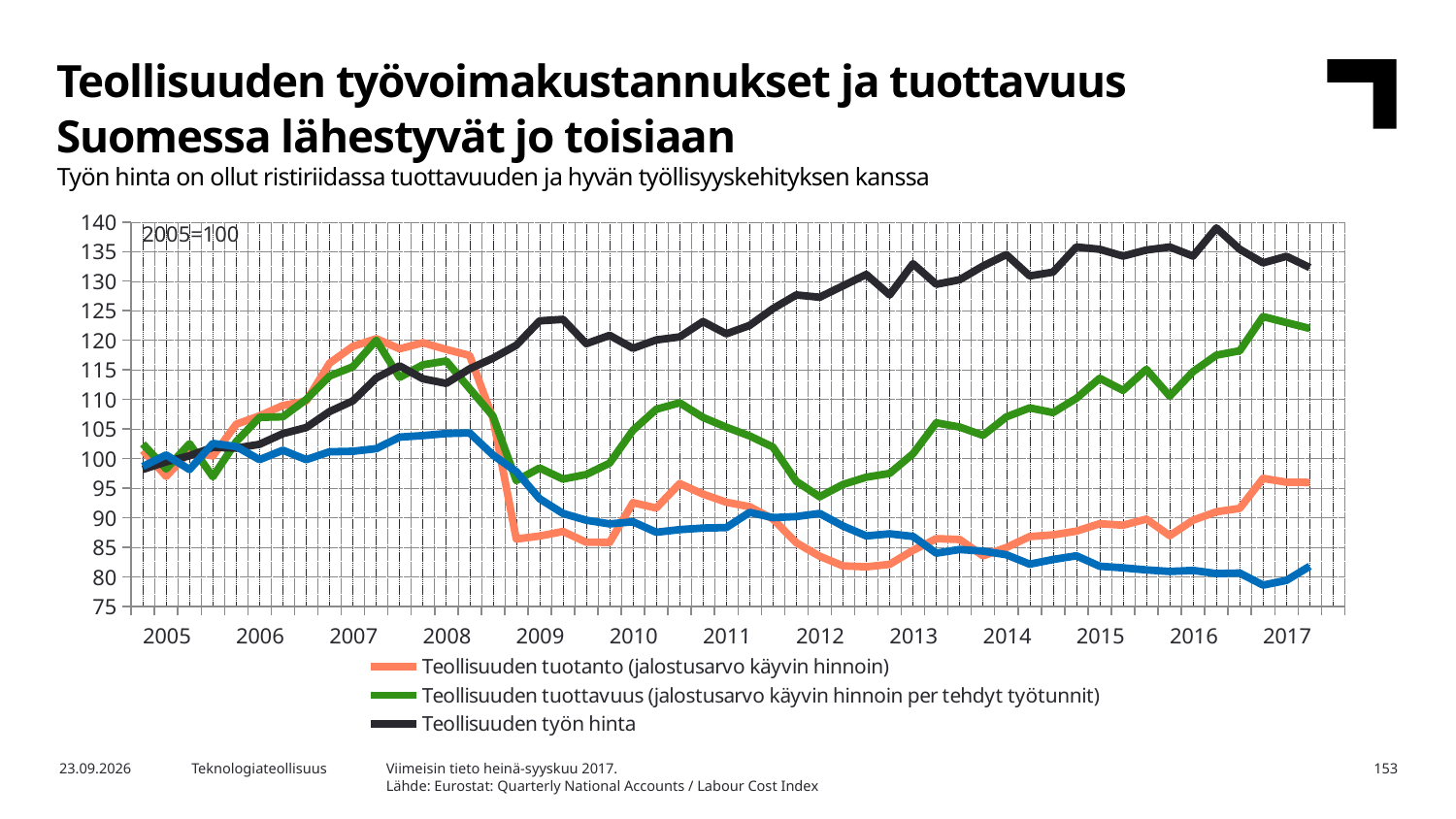
Is the peak value of Teollisuuden työn hinta around 2016 greater or less than 135? greater Is the value of Teollisuuden työn hinta at the end of 2017 greater or less than 125? greater How many series does the chart legend list? 3 How many year labels are shown along the x axis? 13 Which series is highest at the end of the chart in 2017? Teollisuuden työn hinta Which colour is used for the Teollisuuden työn hinta series? Black At the end of 2017, which is higher: Teollisuuden tuottavuus or Teollisuuden tuotanto? Teollisuuden tuottavuus Does the Teollisuuden työn hinta series rise or fall overall from 2005 to 2017? Rise What kind of chart is shown on the slide? Line chart Is the value of Teollisuuden tuotanto (jalostusarvo käyvin hinnoin) at the end of 2017 greater or less than 100? less What base-year index note is printed in the top-left corner of the plot area? 2005=100